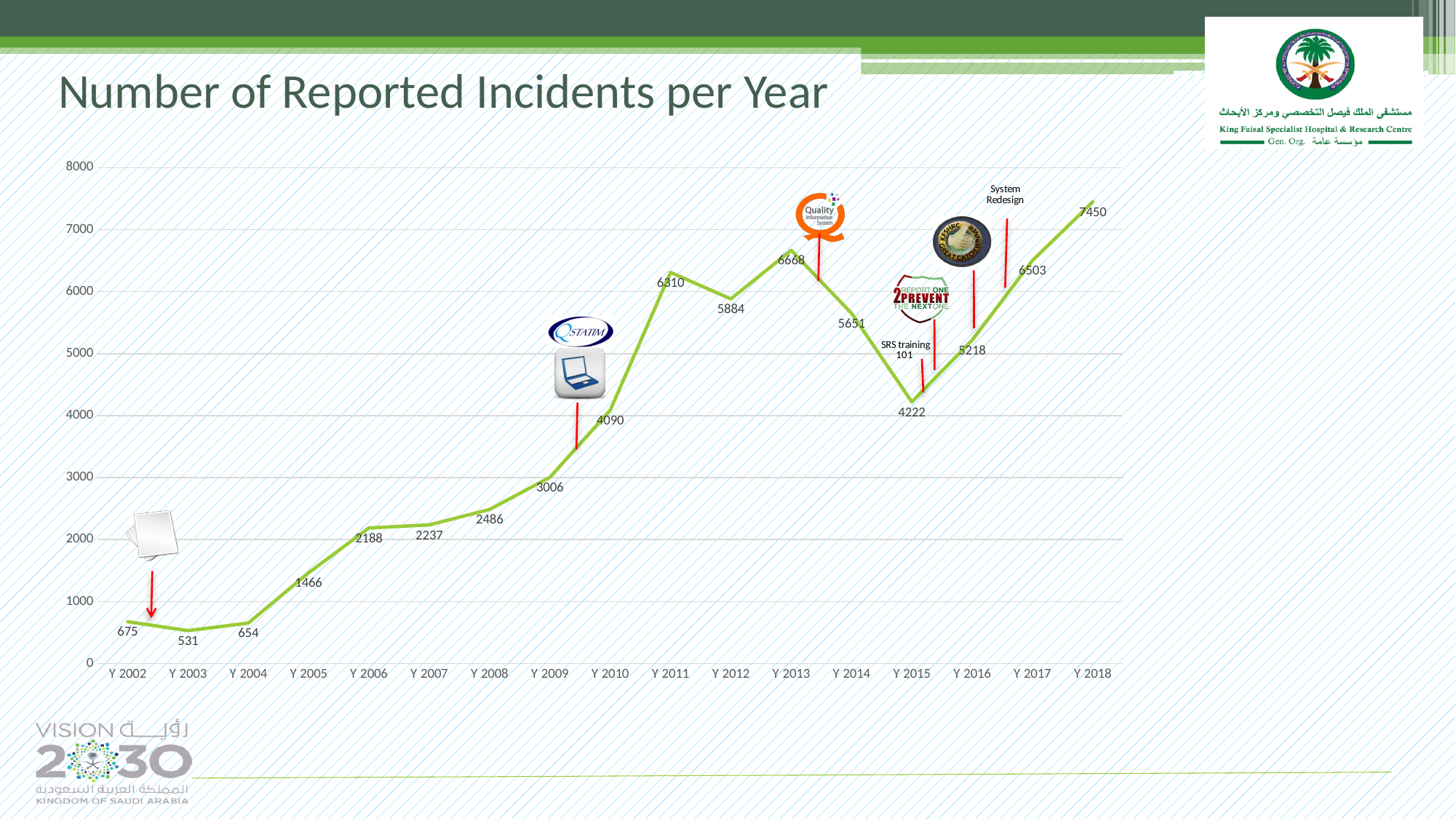
Which year has the lowest number of reported incidents? Y 2003 Which year has more reported incidents, Y 2011 or Y 2012? Y 2011 How many years are plotted on the x axis? 17 What is the difference in reported incidents between Y 2018 and Y 2017? 947 Which year has the highest number of reported incidents? Y 2018 What is the number of reported incidents for Y 2015? 4222 What is the number of reported incidents for Y 2005? 1466 What is the difference in reported incidents between Y 2013 and Y 2014? 1017 Is the value for Y 2016 greater or less than 5000? greater What is the title of the chart? Number of Reported Incidents per Year What is the number of reported incidents for Y 2010? 4090 What type of chart is shown on the slide? Line chart